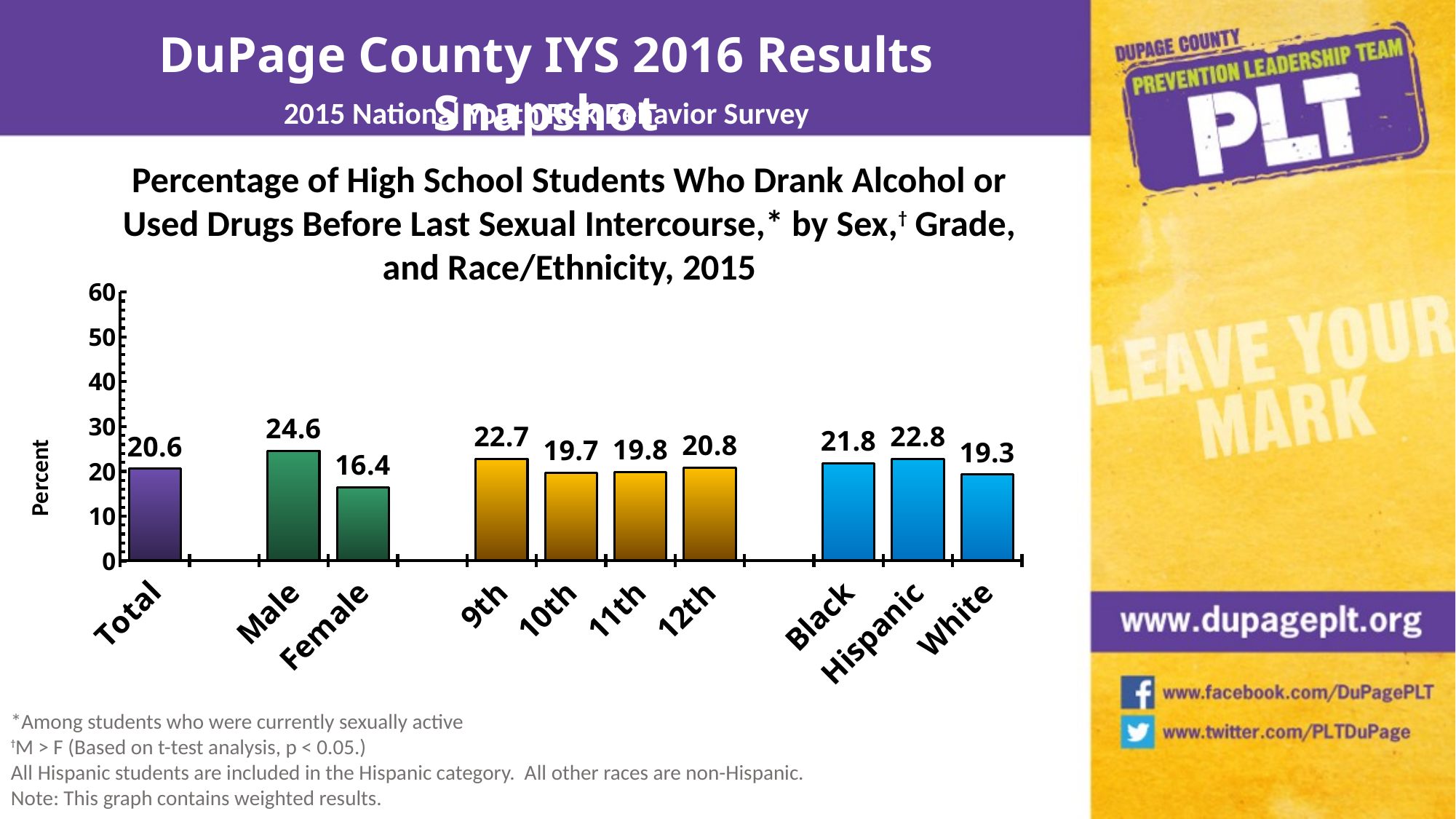
Which is larger, the value for 9th grade or the value for 10th grade? 9th What is the value for Female? 16.4 What is the value for 12th grade? 20.8 How many categories are shown on the x axis? 10 Is the value for Black greater or less than 30? less Which category has the lowest value? Female Which category has the highest value? Male What is the difference between the Male and Female values? 8.2 What kind of chart is this? bar chart What is the value for Total? 20.6 What is the value for Hispanic? 22.8 What is the label on the y axis? Percent